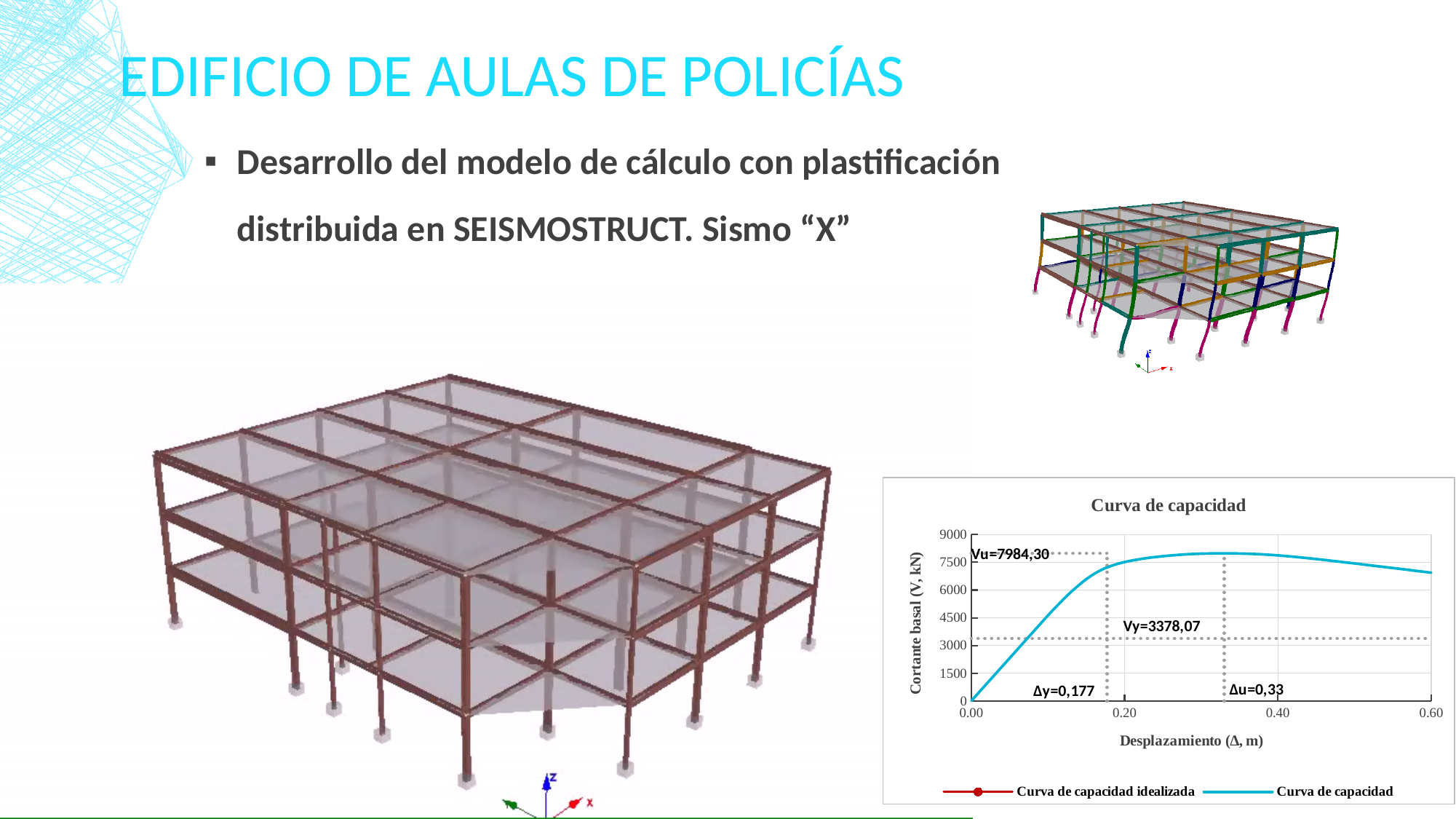
In the 'Curva de capacidad' chart, which is larger, Vu or Vy? Vu In the 'Curva de capacidad' chart, what is the difference between Vu and Vy? 4606,23 How many series does the legend of the 'Curva de capacidad' chart list? 2 In the 'Curva de capacidad' chart, does the curve rise or fall between displacements of 0.00 and 0.20 m? rise In the 'Curva de capacidad' chart, what is the value of Δu? 0,33 What is the title of the chart on the slide? Curva de capacidad In the 'Curva de capacidad' chart, is the base shear at a displacement of 0.20 m greater or less than 6000? greater In the 'Curva de capacidad' chart, what is the value of Δy? 0,177 What kind of chart is the 'Curva de capacidad' chart? line chart In the 'Curva de capacidad' chart, what is the value of Vu? 7984,30 What is the label of the x axis of the 'Curva de capacidad' chart? Desplazamiento (Δ, m) In the 'Curva de capacidad' chart, what is the value of Vy? 3378,07